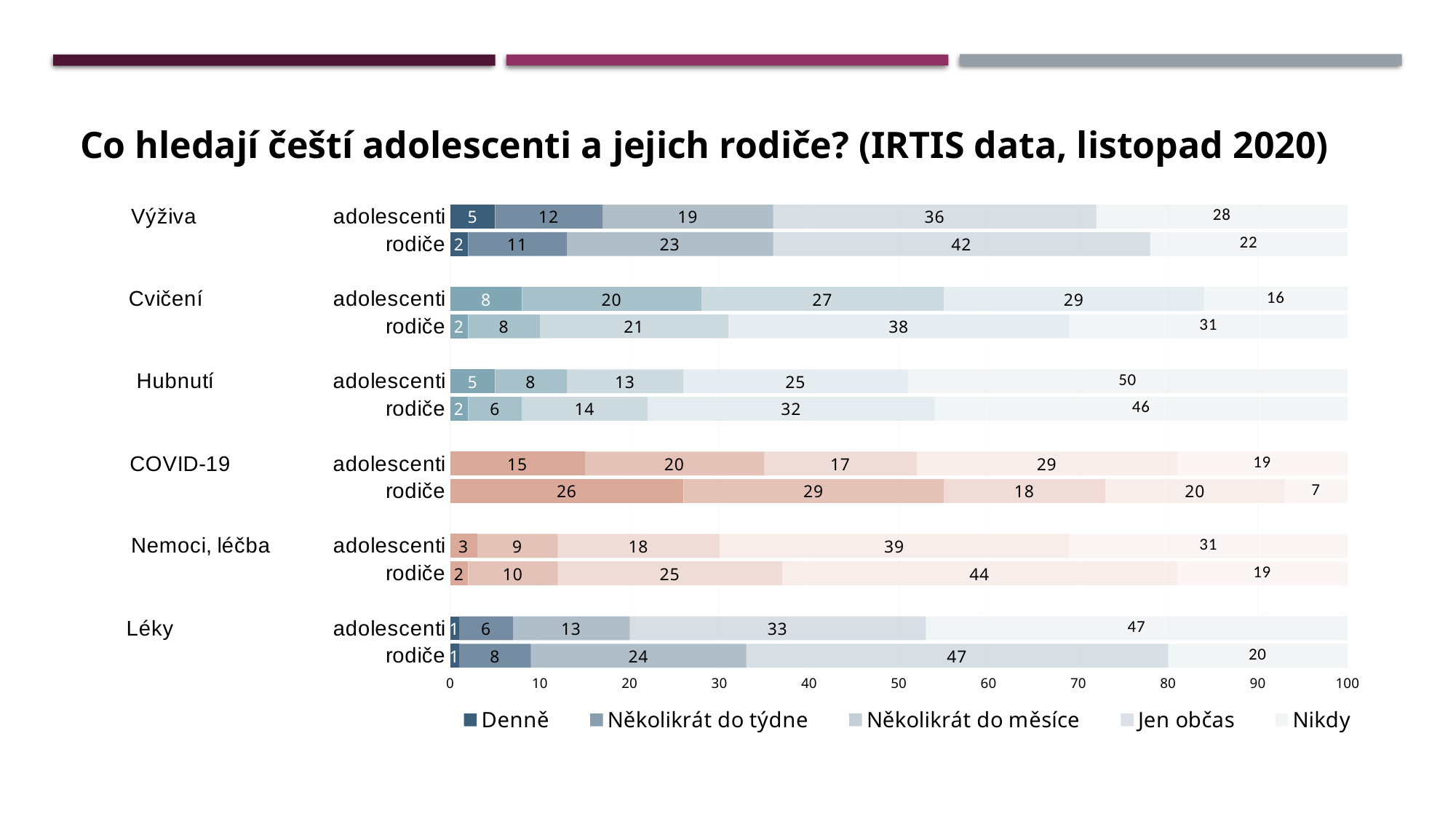
What is the 'Nikdy' value for Hubnutí adolescenti? 50 What is the last legend entry? Nikdy What kind of chart is shown on the slide? stacked bar chart What is the 'Denně' value for COVID-19 rodiče? 26 What is the difference between the 'Nikdy' values for Léky adolescenti and Léky rodiče? 27 How many topic categories are shown on the chart? 6 How many series does the legend list? 5 Which bar has the lowest 'Nikdy' value? COVID-19 rodiče What is the 'Jen občas' value for Výživa rodiče? 42 What is the total of the stacked bar for Výživa adolescenti? 100 Which is larger: the 'Denně' value for COVID-19 adolescenti or for COVID-19 rodiče? COVID-19 rodiče Which bar has the highest 'Nikdy' value? Hubnutí adolescenti